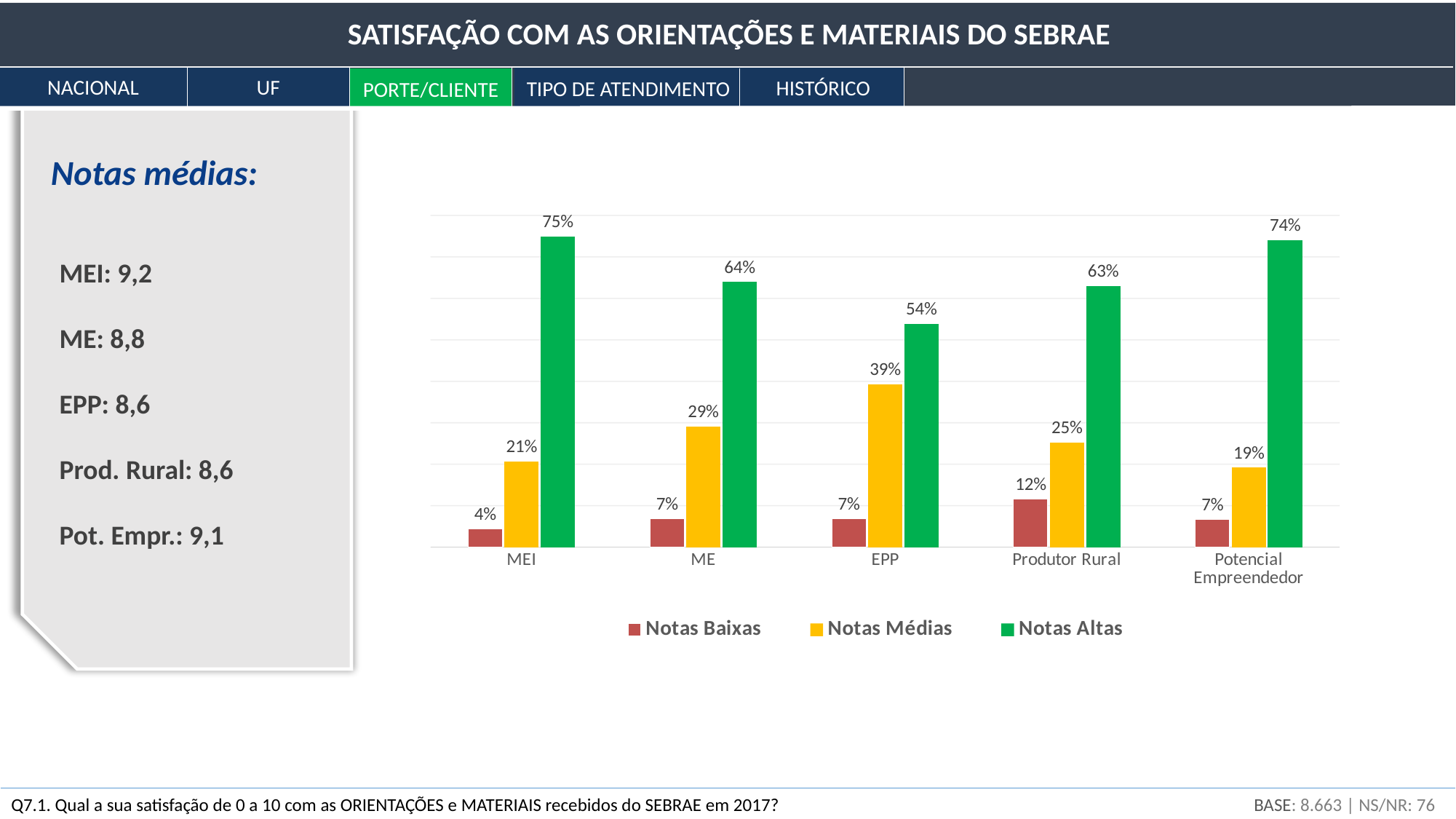
Which category has the highest Notas Médias value? EPP What is the Notas Altas value for Potencial Empreendedor? 74% How many categories are shown on the x axis? 5 Which is larger: the Notas Médias value for ME or for Produtor Rural? ME What is the Notas Baixas value for Produtor Rural? 12% What is the difference between the Notas Altas values for MEI and ME? 11% What kind of chart is shown on the slide? Bar chart Which colour represents the Notas Altas series? Green What is the Notas Médias value for EPP? 39% What is the Notas Altas value for MEI? 75% Which category has the lowest Notas Altas value? EPP How many series does the legend list? 3